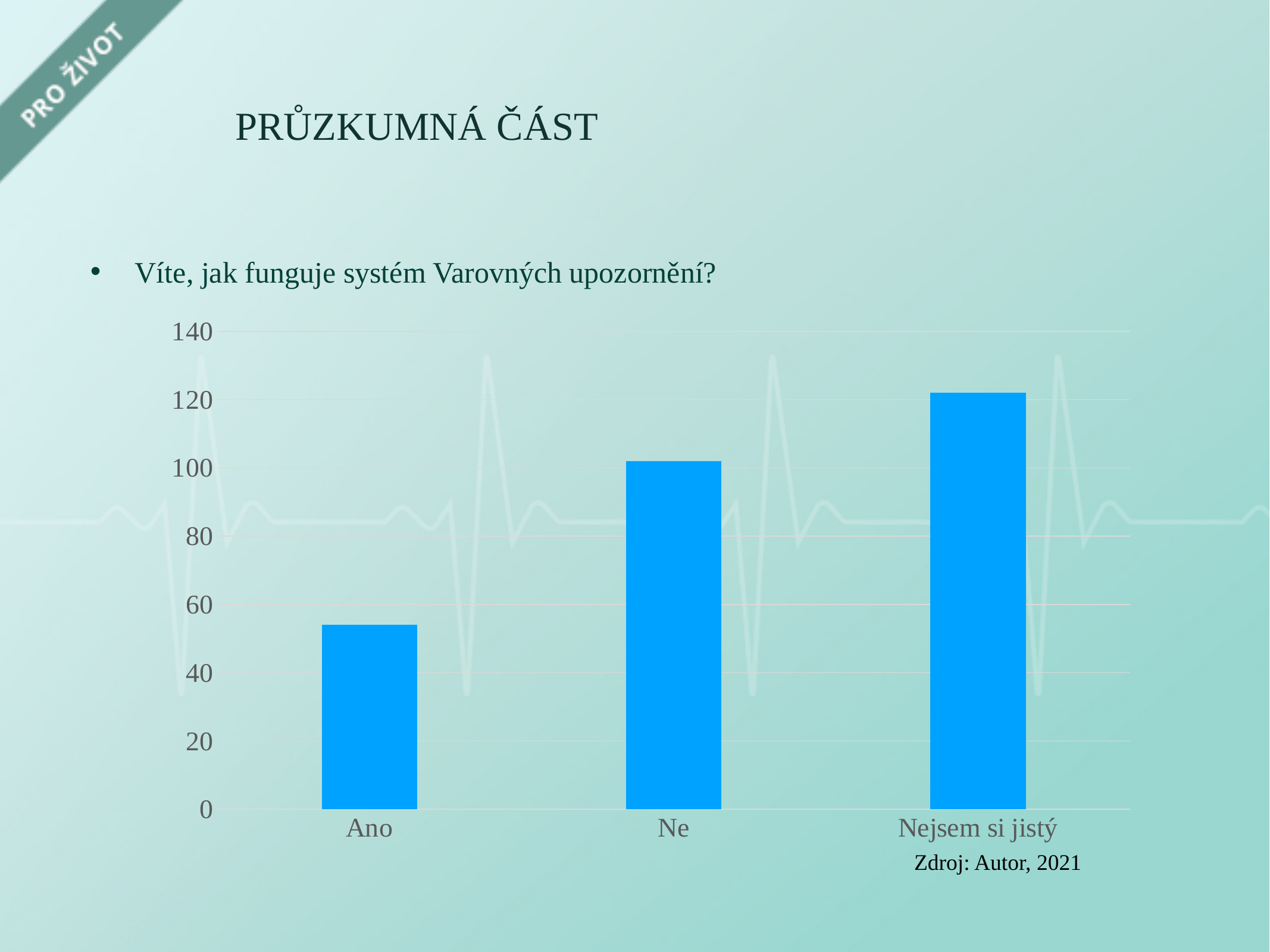
What kind of chart is shown on the slide? bar chart Is the value for Ne greater or less than 80? greater How many categories are shown on the x axis of the chart? 3 Which is larger, the value for Ne or the value for Ano? Ne Do the bar values rise or fall from left to right across the x axis? rise Is the value for Nejsem si jistý greater or less than 140? less Is the value for Nejsem si jistý greater or less than 100? greater What question does the chart on the slide present results for? Víte, jak funguje systém Varovných upozornění? Which category has the lowest bar in the chart? Ano Which category has the highest bar in the chart? Nejsem si jistý